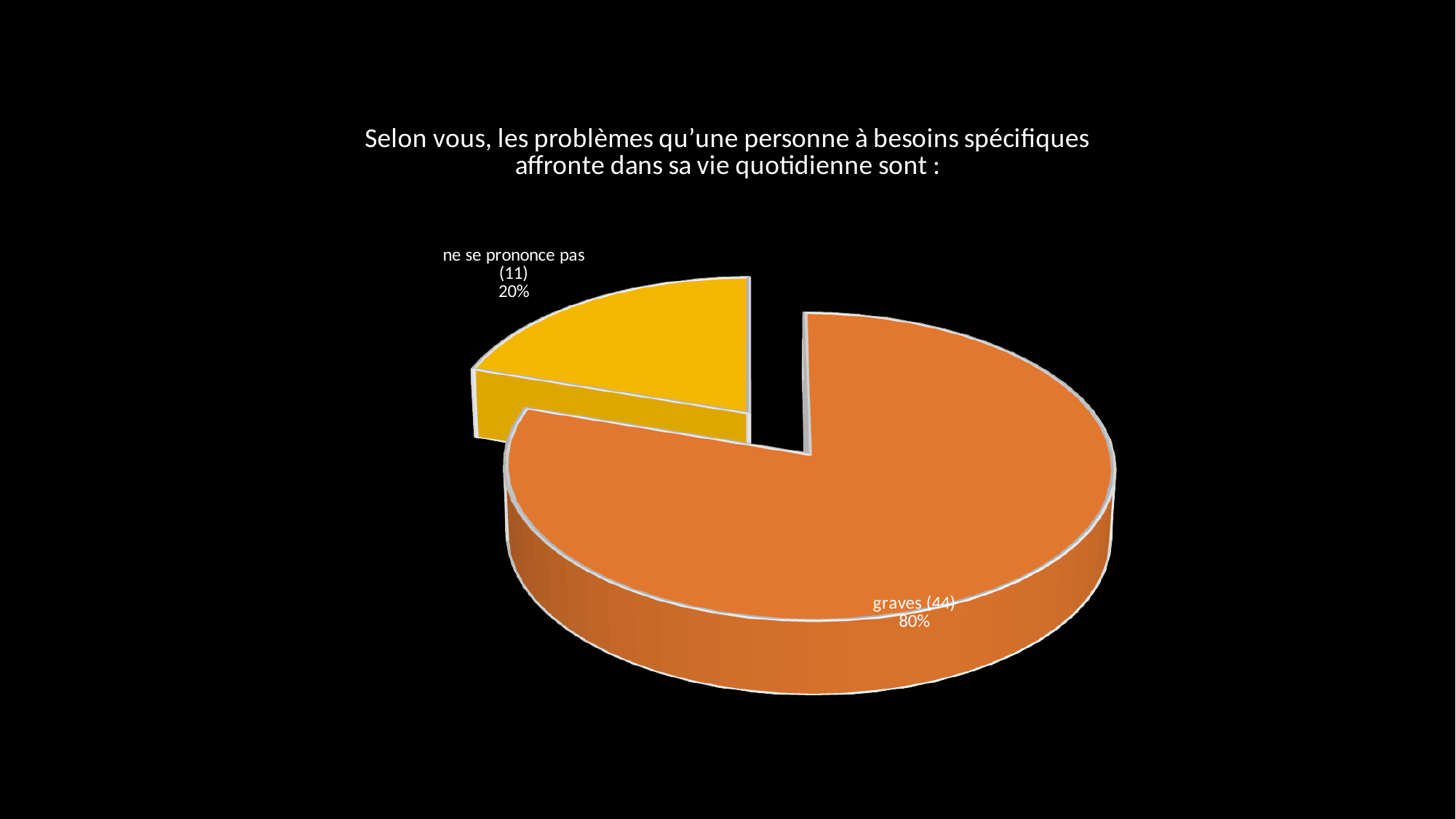
What percentage share does the 'graves' slice represent? 80% What is the difference in count between 'graves' and 'ne se prononce pas'? 33 What is the count shown for the 'ne se prononce pas' category? 11 Which category has the largest slice of the pie? graves What kind of chart is shown on the slide? pie chart What is the total count across both slices of the pie? 55 What is the count shown for the 'graves' category? 44 Which category has the smallest slice of the pie? ne se prononce pas What percentage share does the 'ne se prononce pas' slice represent? 20% Which is larger, the share for 'graves' or the share for 'ne se prononce pas'? graves How many slices does the pie chart have? 2 What colour is the 'ne se prononce pas' slice? yellow